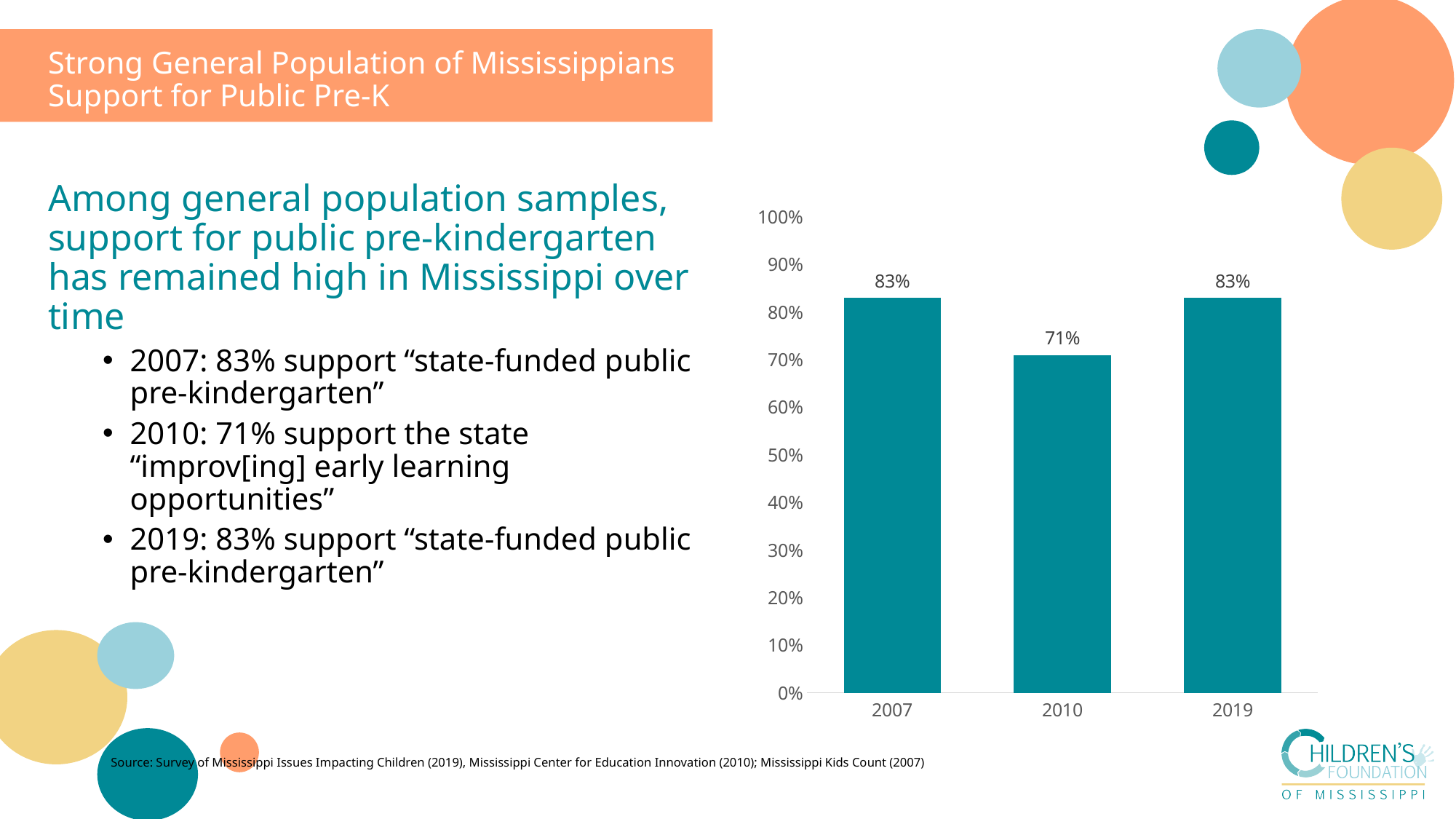
What is the difference between the values for 2019 and 2010? 12% Which is larger, the value for 2010 or the value for 2019? 2019 How many years are shown on the x axis of the chart? 3 What is the difference between the values for 2007 and 2010? 12% What kind of chart is shown on the slide? Bar chart What is the value shown for 2010? 71% Is the value for 2010 greater or less than 80%? less Is the value for 2007 greater or less than 80%? greater What is the value shown for 2019? 83% What is the highest value labelled on the y axis of the chart? 100% Which year has the lowest value in the chart? 2010 What is the value shown for 2007? 83%